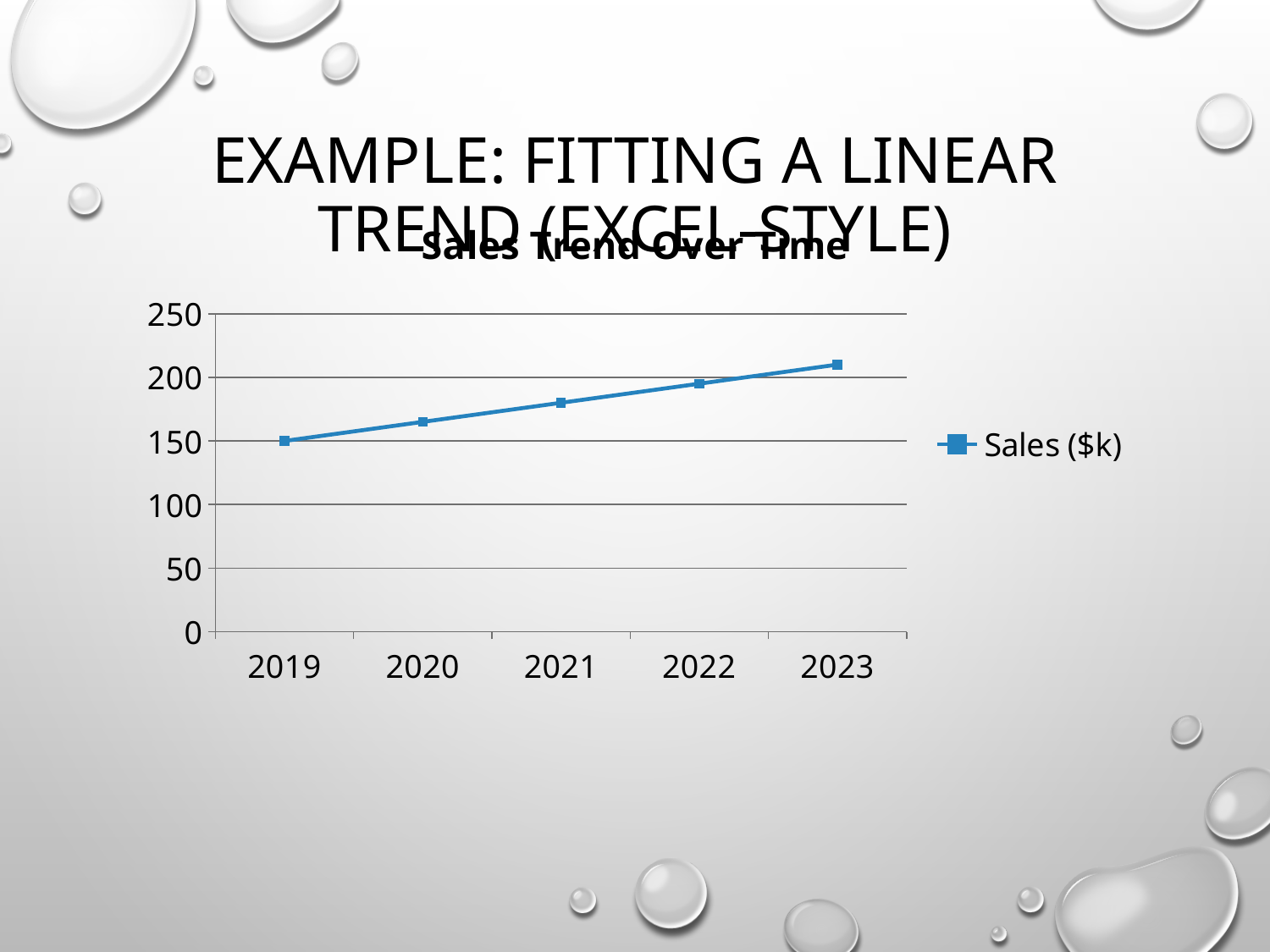
How many series does the legend list? 1 Which year has the highest sales value? 2023 What is the title of the chart? Sales Trend Over Time What series does the legend list? Sales ($k) What kind of chart is shown on the slide? line chart How many years are plotted on the x axis? 5 Is the value for 2021 greater or less than 200? less Is the value for 2023 greater or less than 200? greater Which year has the lowest sales value? 2019 Is the value for 2020 greater or less than 150? greater Do the sales values rise or fall from 2019 to 2023? rise Which year has the larger sales value, 2020 or 2022? 2022